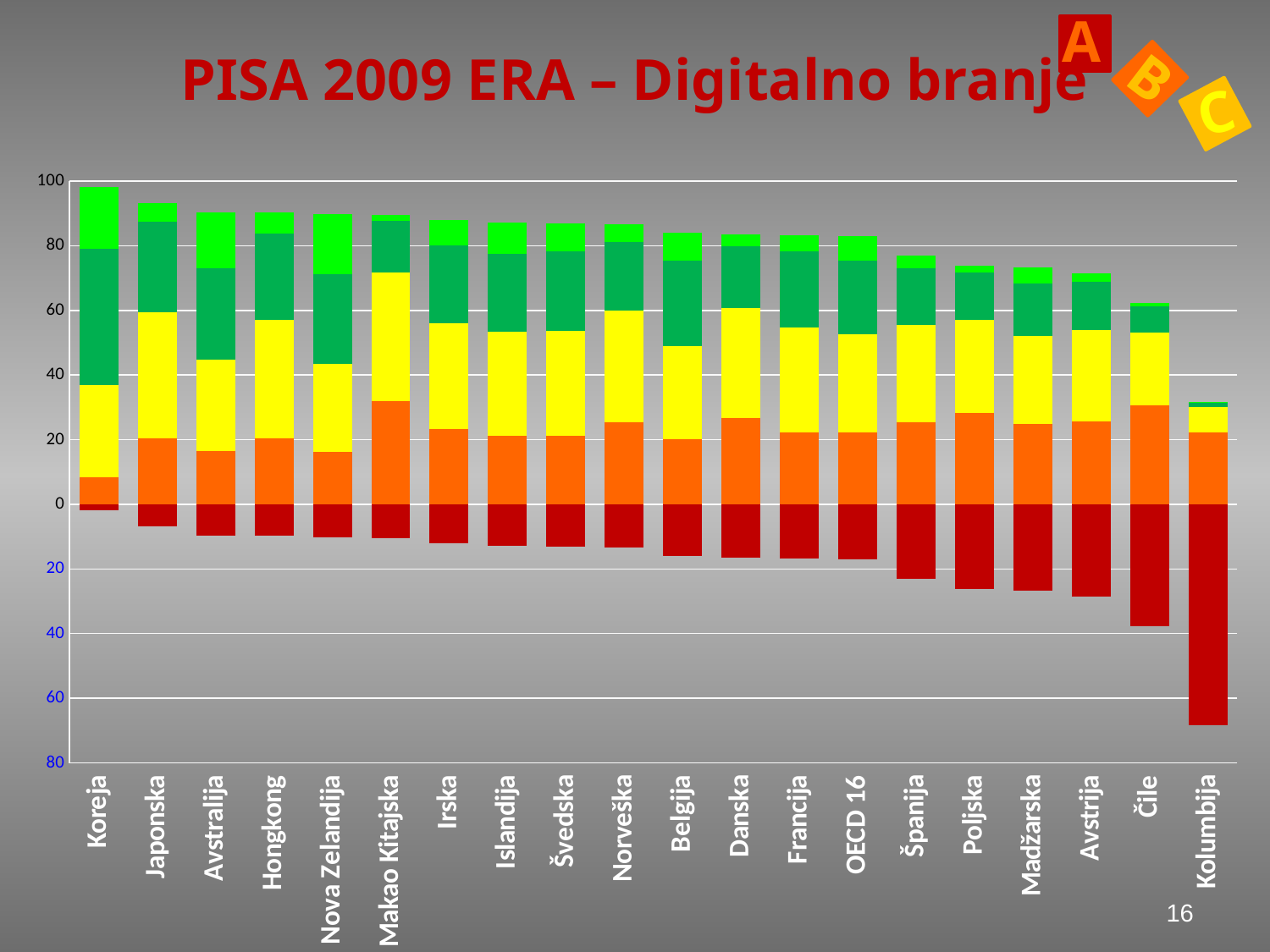
How many countries/categories are shown along the x axis of the chart? 20 Is the bar below zero for Kolumbija greater or less than 60 in magnitude? greater Is the top of the stacked bar above zero for Koreja greater or less than 80? greater Which category has the smallest stacked bar above zero? Kolumbija Do the heights of the stacked bars above zero generally rise or fall from left to right along the x axis? fall Which category has the largest bar extending below zero? Kolumbija Is the top of the stacked bar above zero for Kolumbija greater or less than 40? less Which has the larger bar below zero, Koreja or Kolumbija? Kolumbija What is the title of the slide containing the chart? PISA 2009 ERA – Digitalno branje What kind of chart is shown on the slide? stacked bar chart Which category has the tallest stacked bar above zero? Koreja